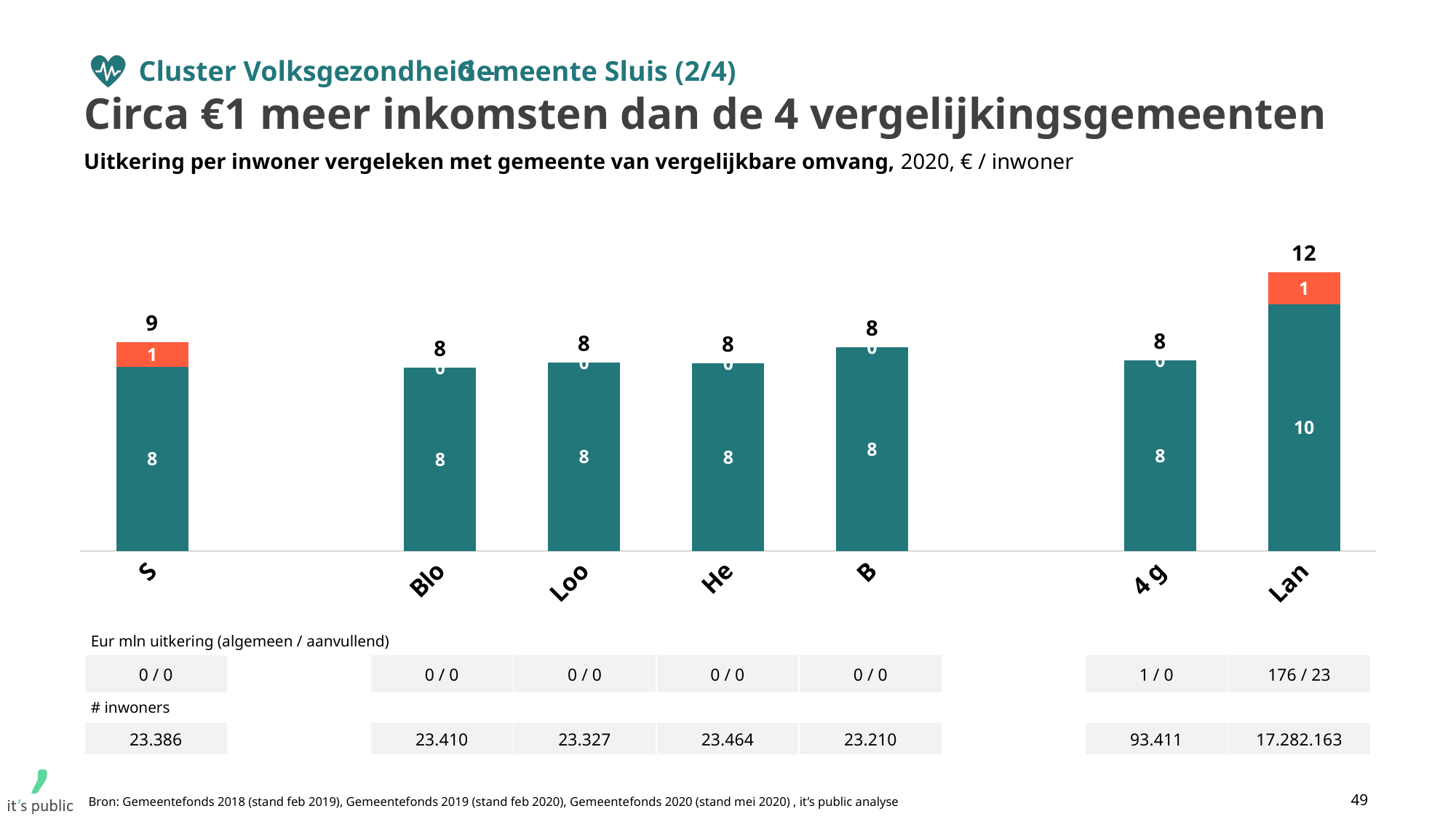
Which category has the highest total value? Lan Which is larger, the total for S or the total for He? S How many categories are shown on the x axis of the chart? 7 What is the difference between the total for S and the total for Blo? 1 What is the difference between the total for Lan and the total for 4 g? 4 What kind of chart is shown on the slide? Stacked bar chart What is the value of the orange (upper) segment of the bar for S? 1 What is the value of the teal (lower) segment of the bar for Lan? 10 What is the total value shown above the bar for Lan? 12 What is the total value shown above the bar for S? 9 What unit is stated in the chart subtitle for the values? € / inwoner